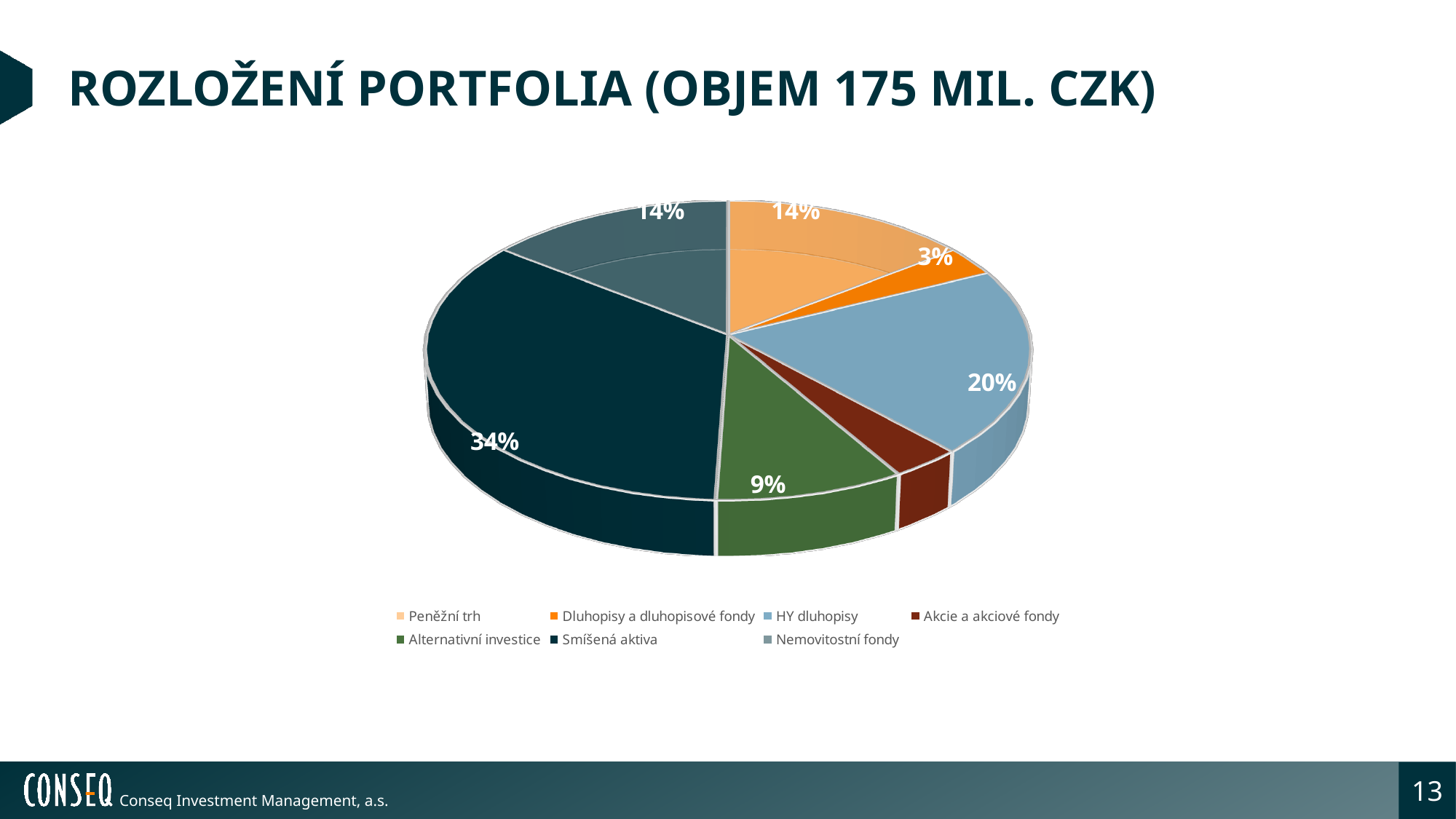
What type of chart is shown on the slide? Pie chart What share of the portfolio is Smíšená aktiva? 34% Which has a larger share: HY dluhopisy or Alternativní investice? HY dluhopisy How many categories does the legend list? 7 What share of the portfolio is Peněžní trh? 14% What is the title of the chart slide? ROZLOŽENÍ PORTFOLIA (OBJEM 175 MIL. CZK) What share of the portfolio is HY dluhopisy? 20% How many percentage points larger is the share of Smíšená aktiva than the share of HY dluhopisy? 14 percentage points What share of the portfolio is Alternativní investice? 9% What share of the portfolio is Dluhopisy a dluhopisové fondy? 3% Which category has the largest share of the portfolio? Smíšená aktiva